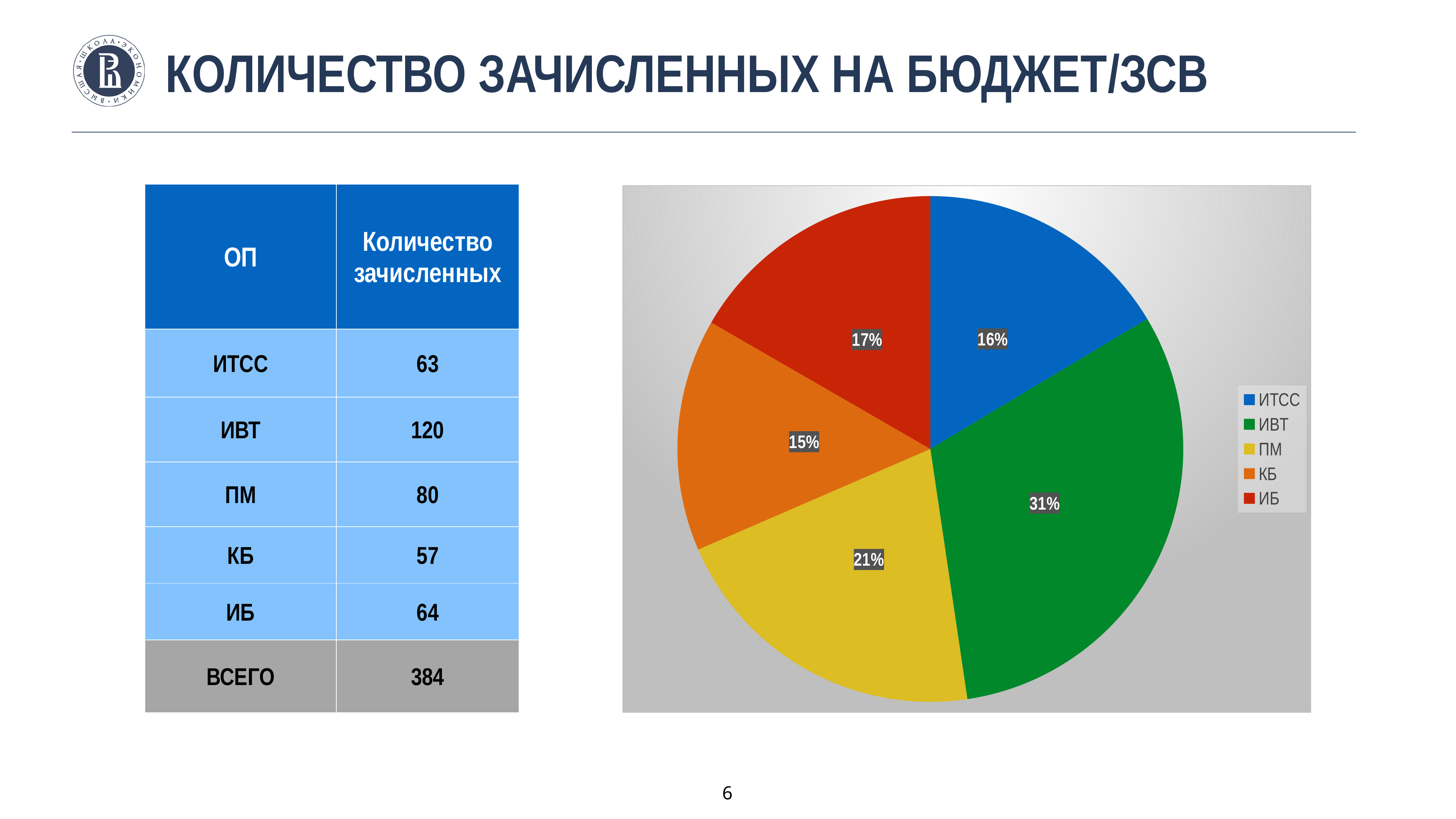
What colour is the ПМ slice in the pie chart? yellow Which slice is larger in the pie chart, ИБ or КБ? ИБ How many categories does the pie chart legend list? 5 Which category has the smallest slice in the pie chart? КБ What type of chart is shown on the slide? pie chart What percentage does the pie chart show for ИБ? 17% What percentage does the pie chart show for ИВТ? 31% What is the difference in percentage points between the ИВТ slice and the ПМ slice? 10 What percentage does the pie chart show for КБ? 15% Which category has the largest slice in the pie chart? ИВТ What percentage does the pie chart show for ПМ? 21% What percentage does the pie chart show for ИТСС? 16%